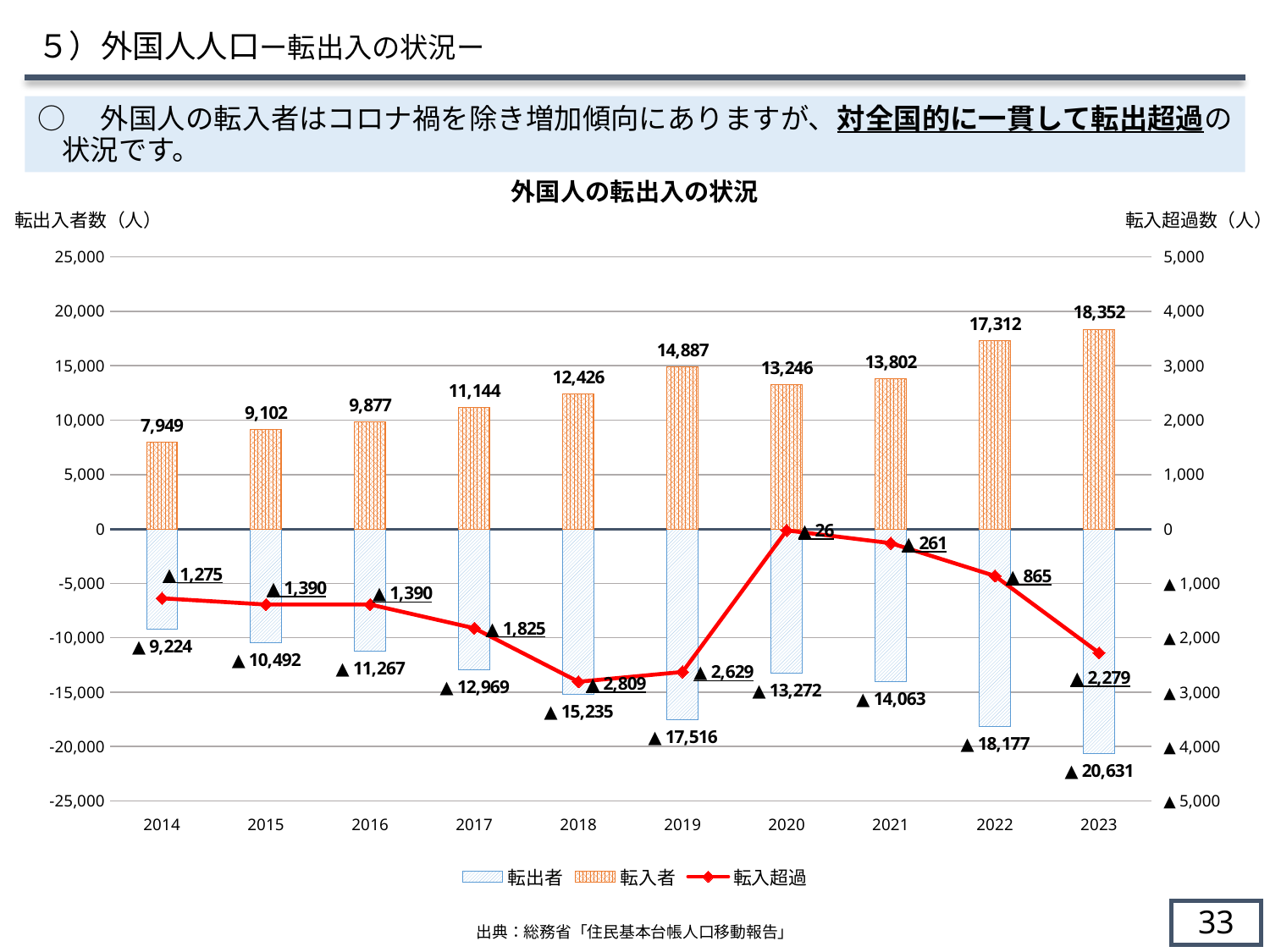
In which year is the 転入者 value highest? 2023 How many series does the legend list? 3 Do the 転入者 values rise or fall from 2014 to 2019? Rise Which year has the larger 転入者 value, 2020 or 2021? 2021 What is the label of the right-hand vertical axis? 転入超過数（人） What is the difference between the 転入者 values for 2023 and 2022? 1,040 In which year is the 転入者 value lowest? 2014 How many years are shown on the x axis? 10 What is the value of 転入者 for 2019? 14,887 What is the value of 転出者 for 2023? ▲ 20,631 What is the value of 転入超過 for 2020? ▲ 26 What kind of chart is this? Combination bar and line chart